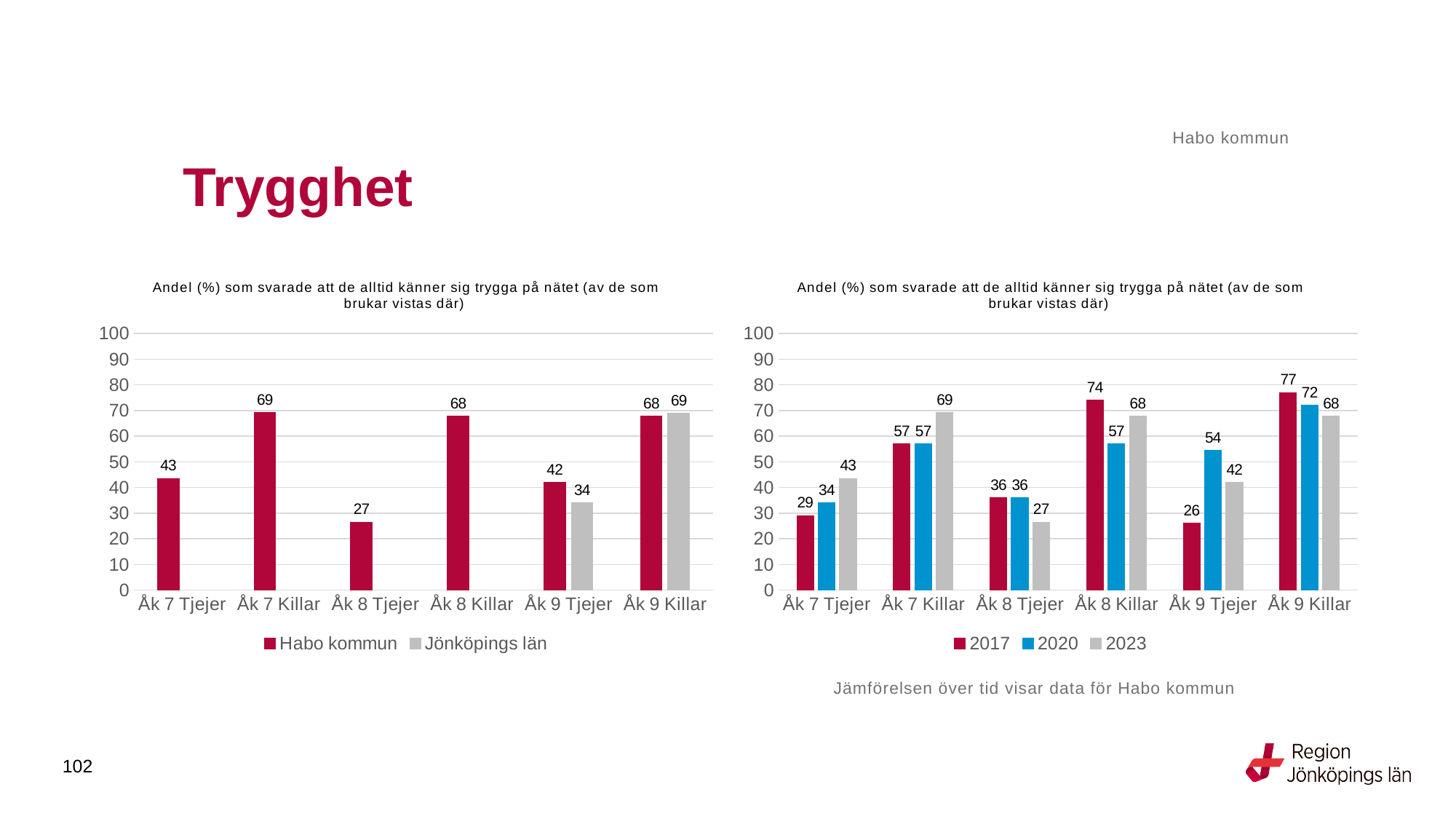
In the left chart, which category has the lowest value for Habo kommun? Åk 8 Tjejer In the right chart, what is the 2020 value for Åk 9 Tjejer? 54 In the right chart, which is larger for Åk 8 Killar: the 2017 value or the 2020 value? 2017 What kind of chart is the right chart? Bar chart In the left chart, which category has the highest value for Habo kommun? Åk 7 Killar In the left chart, what is the value for Habo kommun for Åk 8 Tjejer? 27 In the right chart, how many categories are shown on the x axis? 6 In the left chart, what is the value for Jönköpings län for Åk 9 Tjejer? 34 In the left chart, how many series does the legend list? 2 In the left chart, what is the difference between the Habo kommun values for Åk 7 Killar and Åk 7 Tjejer? 26 In the right chart, what is the difference between the 2023 and 2017 values for Åk 7 Tjejer? 14 In the right chart, what is the 2017 value for Åk 9 Killar? 77